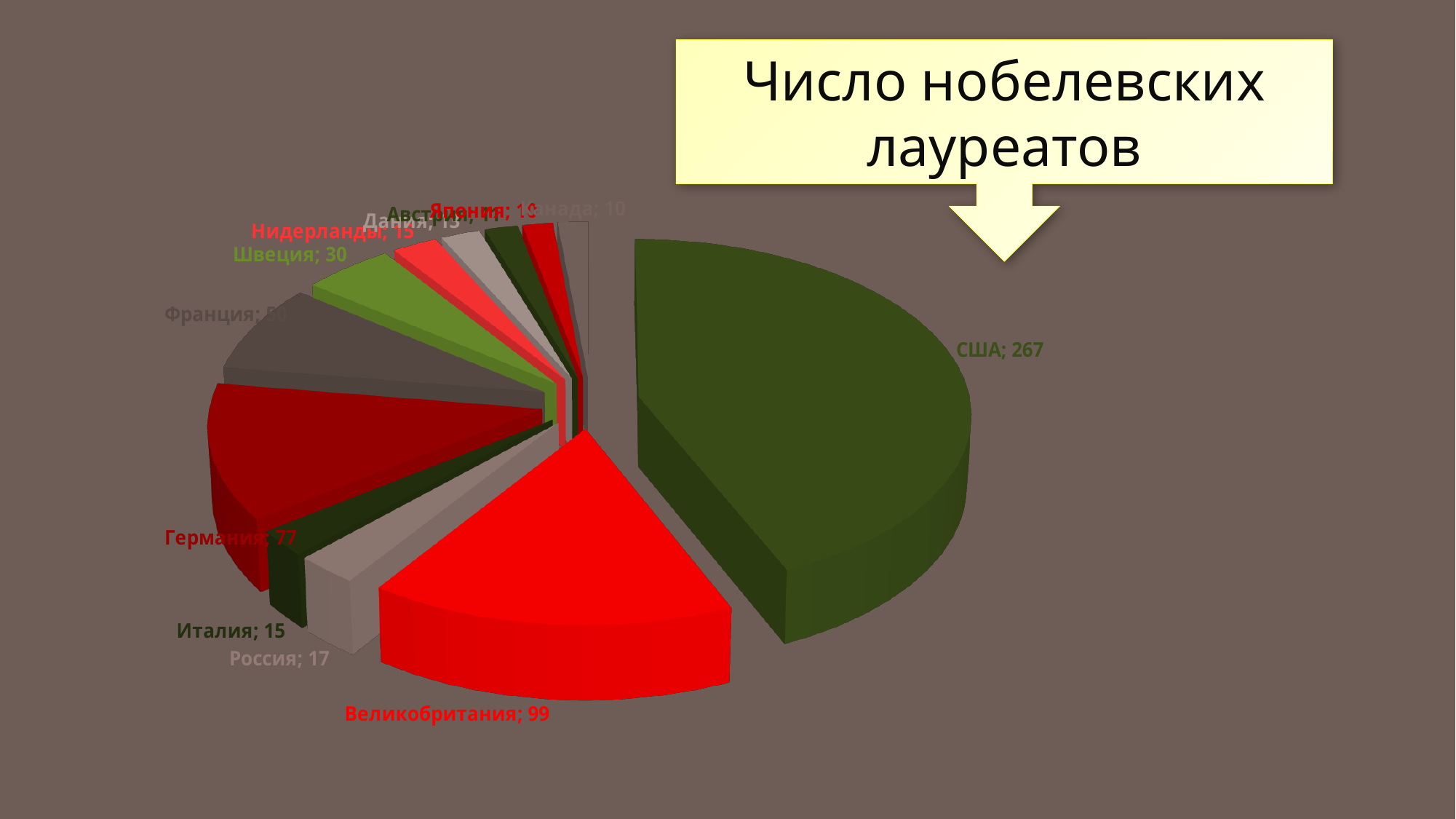
What kind of chart is shown on the slide? Pie chart What is the value shown for Германия? 77 What is the value shown for Великобритания? 99 What is the value shown for Италия? 15 What is the difference between the values for США and Великобритания? 168 What is the difference between the values for Великобритания and Германия? 22 What is the value shown for Россия? 17 What is the title of the chart? Число нобелевских лауреатов What is the value shown for США? 267 Which country has the largest slice of the pie? США Which has a larger value, Германия or Швеция? Германия What is the value shown for Швеция? 30